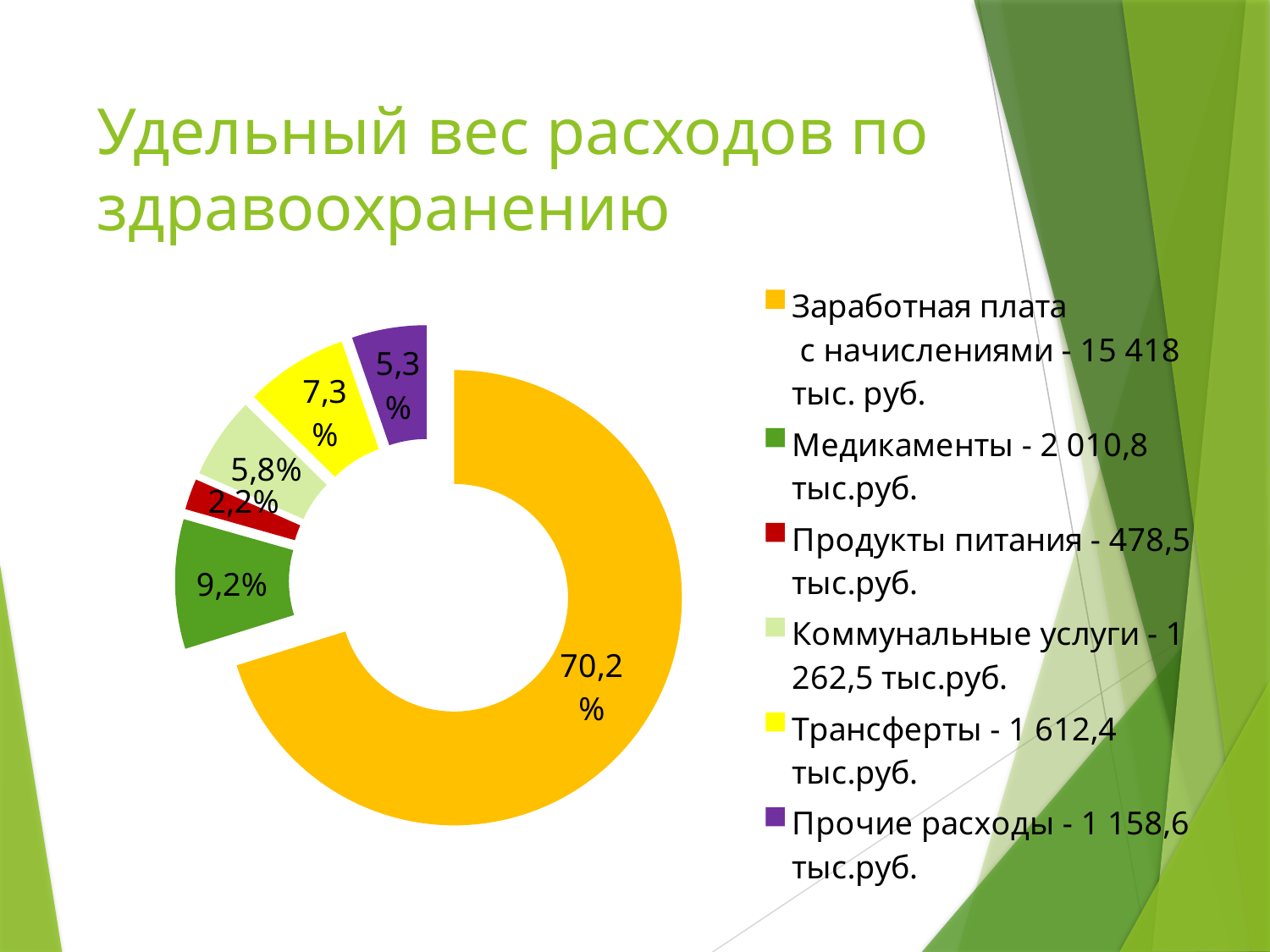
What is the title of the slide? Удельный вес расходов по здравоохранению What share of the chart does Трансферты take? 7,3% What share of the chart does Прочие расходы take? 5,3% What share of the chart does Продукты питания take? 2,2% Which has a larger share: Трансферты or Коммунальные услуги? Трансферты Which category has the smallest share of the chart? Продукты питания Which category has the largest share of the chart? Заработная плата с начислениями What kind of chart is shown on the slide? Doughnut (pie) chart How many categories does the legend list? 6